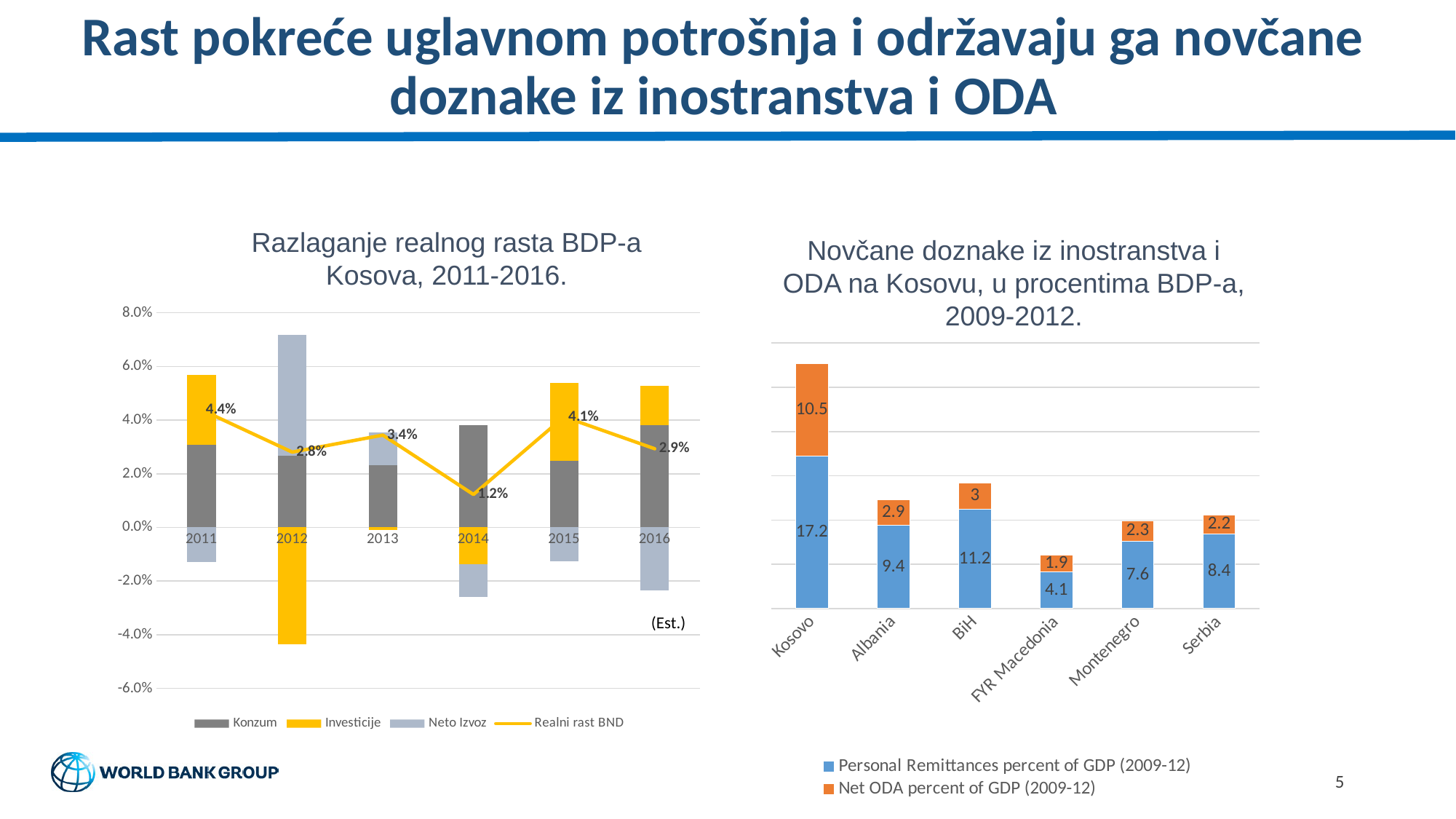
In the chart 'Novčane doznake iz inostranstva i ODA na Kosovu, u procentima BDP-a, 2009-2012.', what is the Personal Remittances percent of GDP value for BiH? 11.2 In the chart 'Razlaganje realnog rasta BDP-a Kosova, 2011-2016.', which year has the highest Realni rast BND value? 2011 In the chart 'Novčane doznake iz inostranstva i ODA na Kosovu, u procentima BDP-a, 2009-2012.', how many countries are shown on the x axis? 6 In the chart 'Razlaganje realnog rasta BDP-a Kosova, 2011-2016.', what is the Realni rast BND value for 2014? 1.2% In the chart 'Novčane doznake iz inostranstva i ODA na Kosovu, u procentima BDP-a, 2009-2012.', what is the total of the stacked bar for Kosovo? 27.7 In the chart 'Novčane doznake iz inostranstva i ODA na Kosovu, u procentima BDP-a, 2009-2012.', which country has the lowest Personal Remittances percent of GDP value? FYR Macedonia In the chart 'Razlaganje realnog rasta BDP-a Kosova, 2011-2016.', what is the difference between the Realni rast BND values for 2015 and 2012? 1.3% In the chart 'Novčane doznake iz inostranstva i ODA na Kosovu, u procentima BDP-a, 2009-2012.', which is larger: the Personal Remittances value for Serbia or for Montenegro? Serbia In the chart 'Razlaganje realnog rasta BDP-a Kosova, 2011-2016.', is the Investicije value for 2012 greater or less than -2.0%? less In the chart 'Novčane doznake iz inostranstva i ODA na Kosovu, u procentima BDP-a, 2009-2012.', what is the Net ODA percent of GDP value for Montenegro? 2.3 In the chart 'Razlaganje realnog rasta BDP-a Kosova, 2011-2016.', how many series does the legend list? 4 What kind of chart is 'Novčane doznake iz inostranstva i ODA na Kosovu, u procentima BDP-a, 2009-2012.'? Stacked bar chart